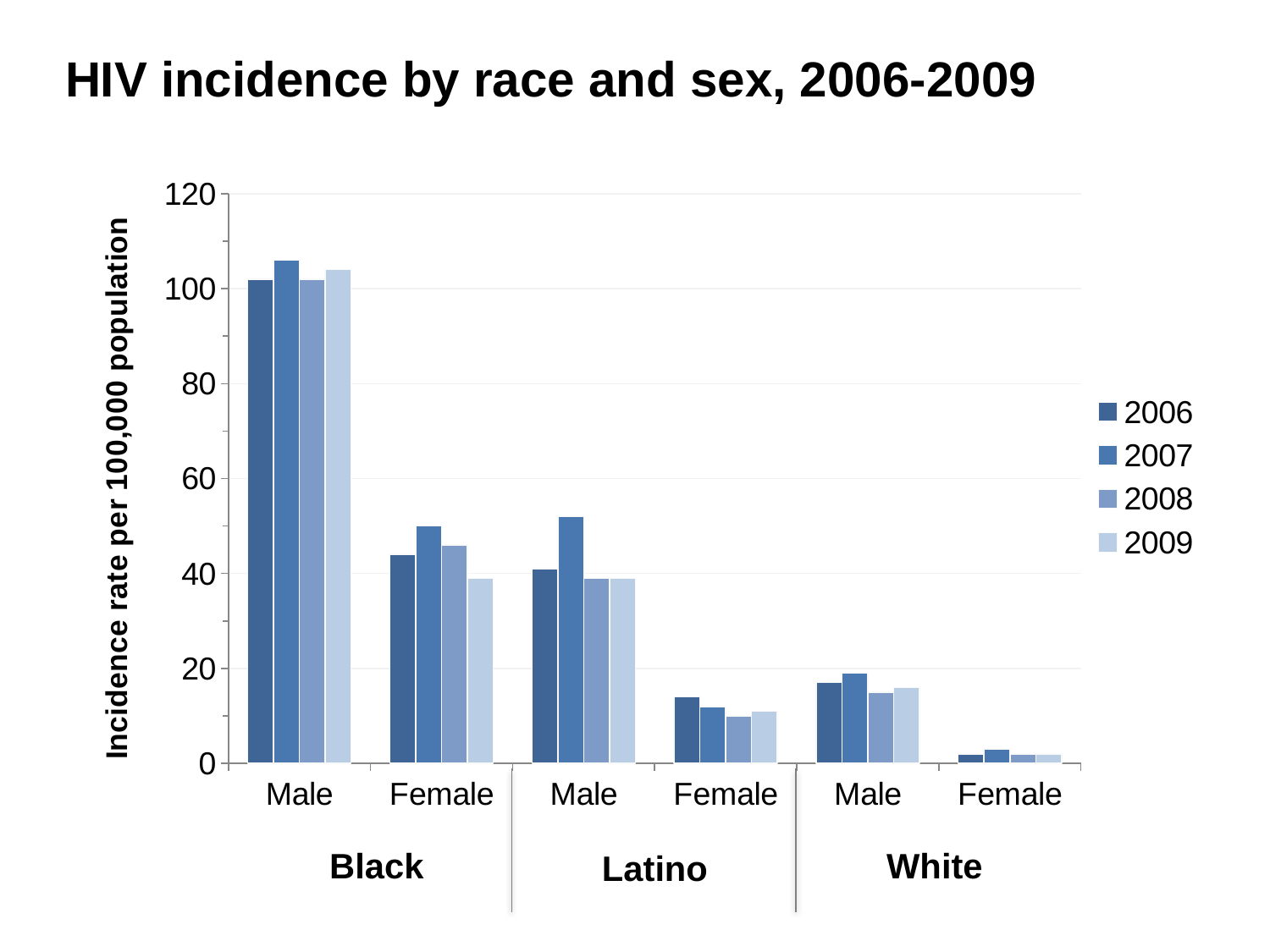
What is the label on the y axis? Incidence rate per 100,000 population How many series does the legend list? 4 For Latino Male, which year has the highest incidence rate? 2007 Is the 2007 value for Black Male greater or less than 100? greater Is the 2007 value for Latino Male greater or less than 40? greater Is the 2006 value for Latino Female greater or less than 20? less Which race and sex group has the lowest incidence rates? White Female What kind of chart is shown on the slide? bar chart Which race and sex group has the highest incidence rates? Black Male Which is larger, the 2007 value for White Male or the 2007 value for Latino Female? White Male How many Male/Female category groups are shown along the x axis? 6